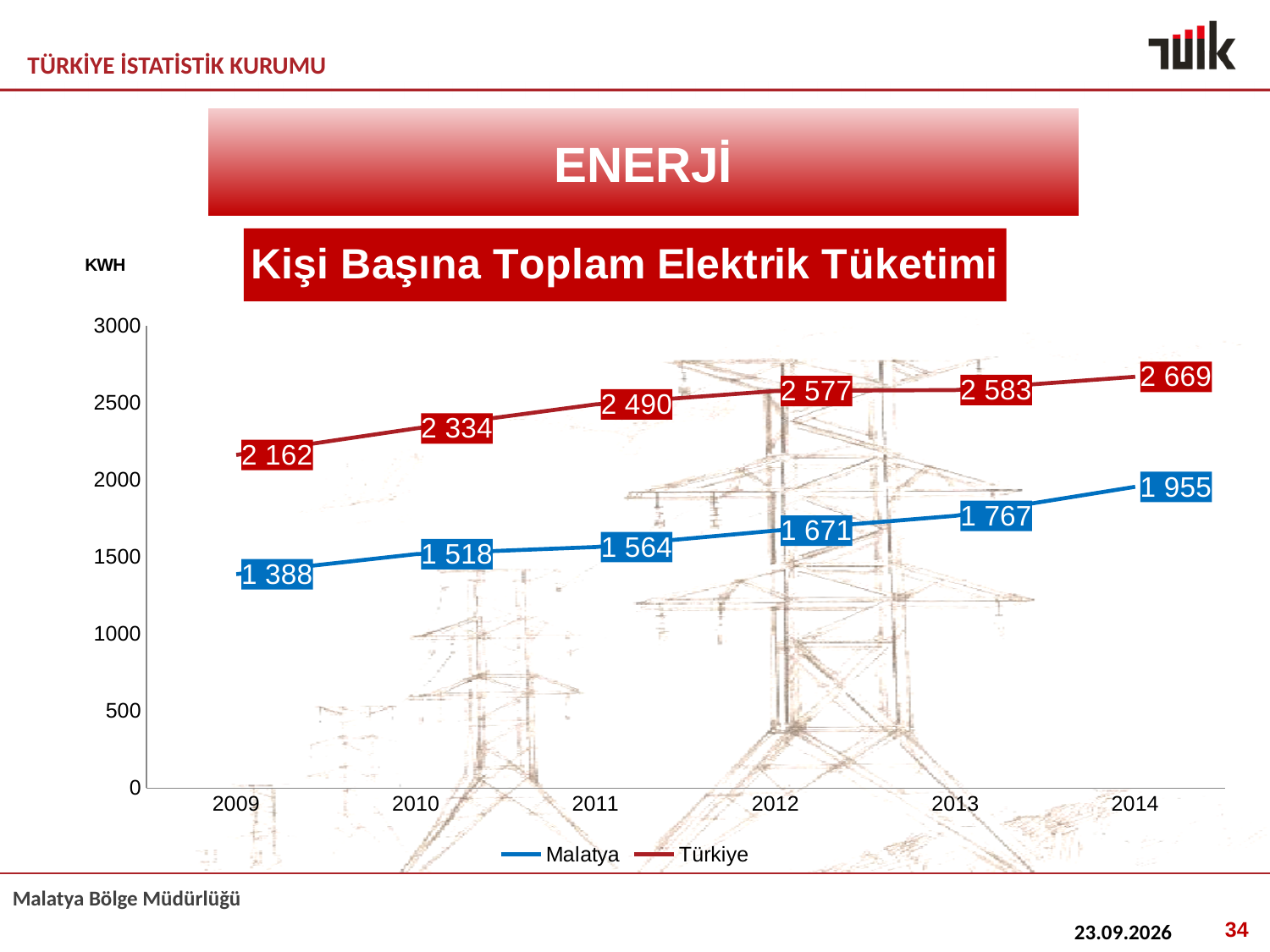
What is the value for Türkiye in 2011? 2 490 What is the value for Malatya in 2013? 1 767 In which year is the Malatya value highest? 2014 In which year is the Türkiye value lowest? 2009 What is the difference between the Türkiye and Malatya values in 2014? 714 What kind of chart is this? line chart Is the value for Malatya in 2014 greater or less than 2000? less What is the value for Malatya in 2009? 1 388 Which is larger in 2012, the Malatya value or the Türkiye value? Türkiye How many series does the legend list? 2 How many years are shown on the x axis? 6 What is the value for Türkiye in 2014? 2 669